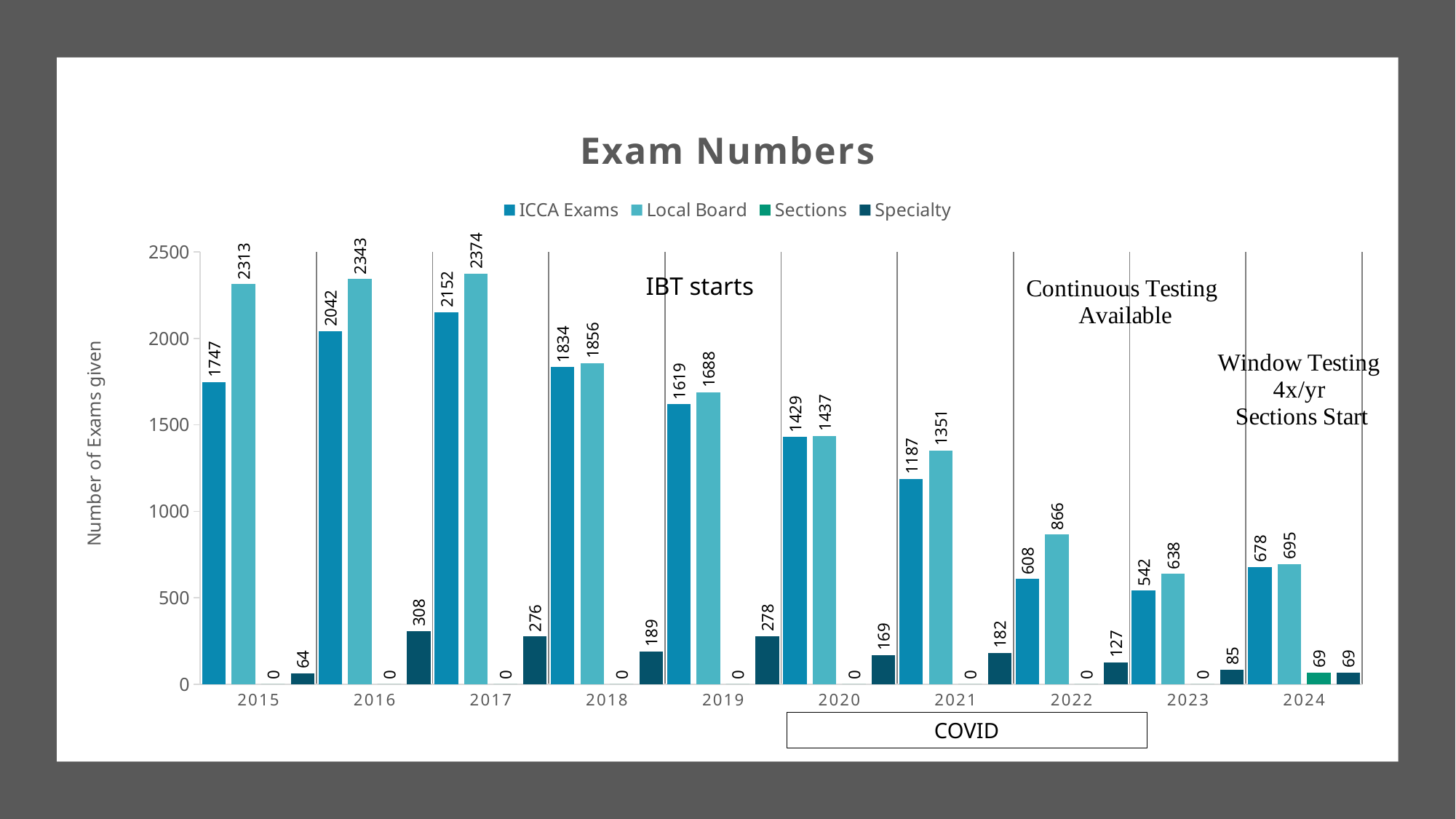
What is the value for Specialty in 2016? 308 What is the difference between the Local Board and ICCA Exams values in 2022? 258 How many years are shown on the x axis? 10 In which year is the ICCA Exams value lowest? 2023 What is the title of the chart? Exam Numbers How many series does the legend list? 4 Which is larger in 2015, ICCA Exams or Local Board? Local Board In which year is the Local Board value highest? 2017 What is the value for Sections in 2024? 69 What is the value for Local Board in 2021? 1351 What type of chart is shown on the slide? bar chart What is the value for ICCA Exams in 2017? 2152